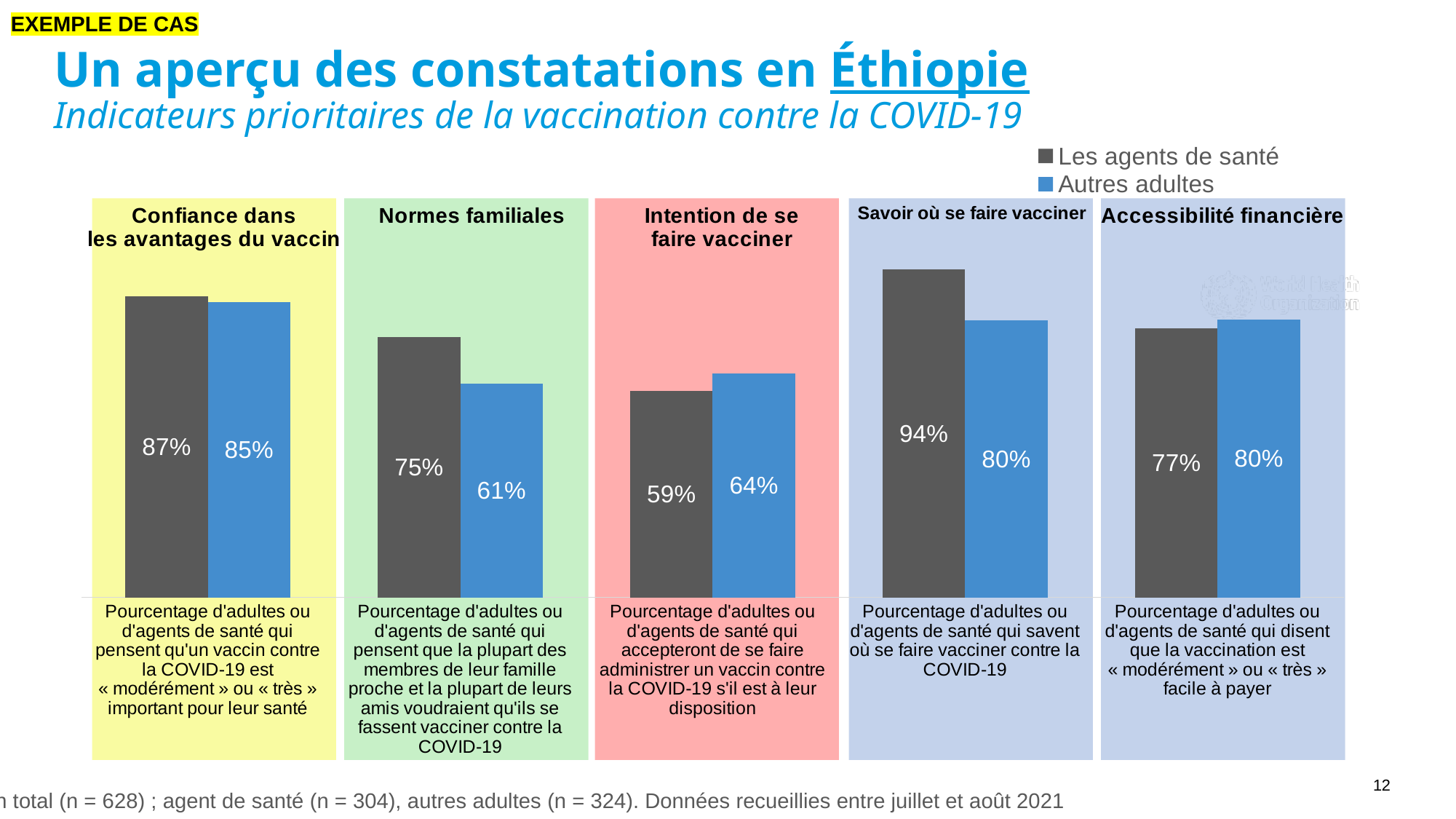
How many series does the legend list? 2 What value is shown for 'Les agents de santé' in the 'Intention de se faire vacciner' category? 59% In which category is the value for 'Les agents de santé' lowest? Intention de se faire vacciner In the 'Accessibilité financière' category, which series has the larger value? Autres adultes How many categories are shown in the chart? 5 What is the difference between 'Les agents de santé' and 'Autres adultes' in the 'Normes familiales' category? 14 percentage points What value is shown for 'Autres adultes' in the 'Normes familiales' category? 61% What value is shown for 'Les agents de santé' in the 'Confiance dans les avantages du vaccin' category? 87% What value is shown for 'Autres adultes' in the 'Savoir où se faire vacciner' category? 80% What is the difference between 'Les agents de santé' and 'Autres adultes' in the 'Savoir où se faire vacciner' category? 14 percentage points What kind of chart is shown on the slide? Bar chart In which category is the value for 'Les agents de santé' highest? Savoir où se faire vacciner